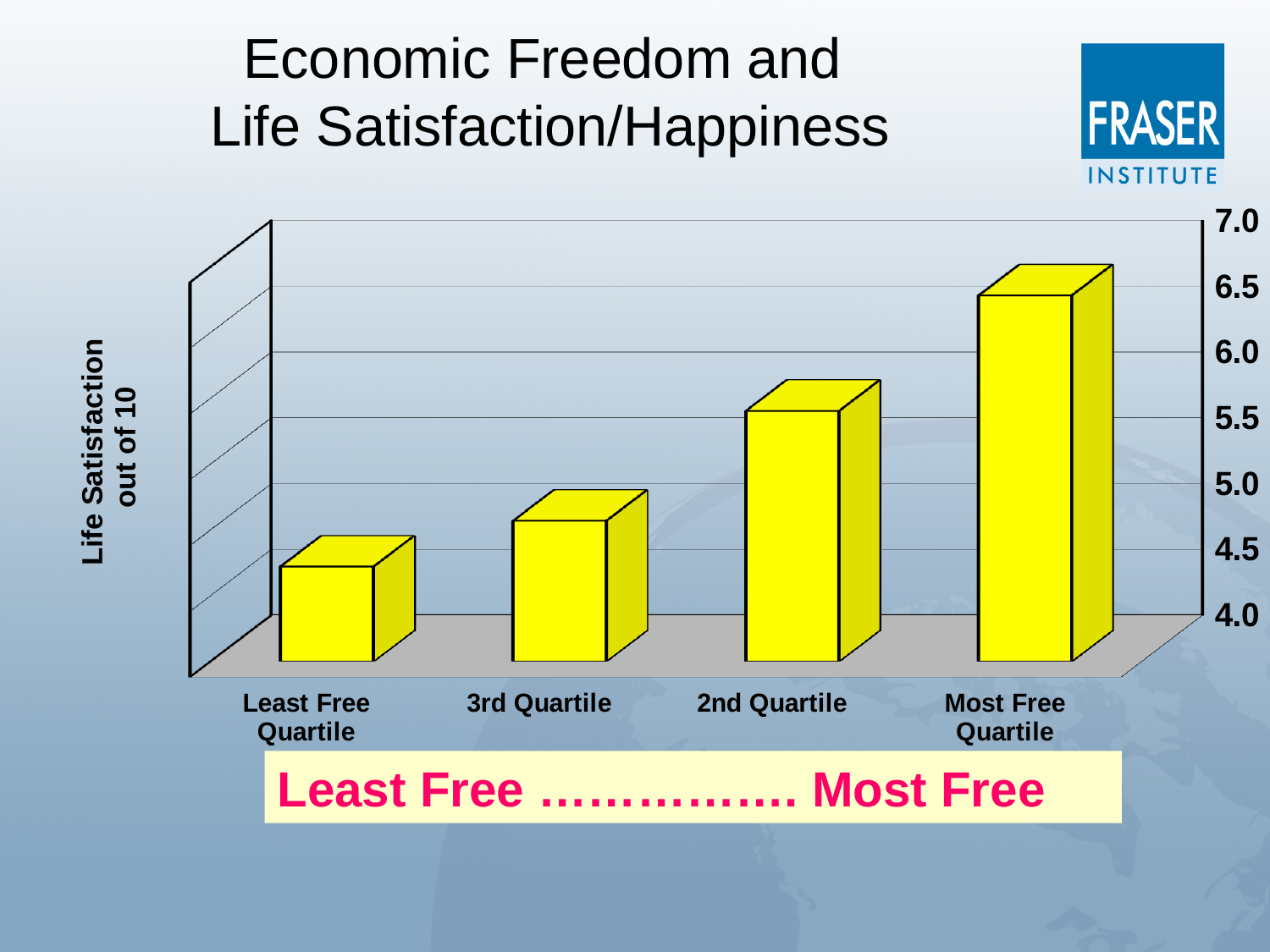
What kind of chart is shown on the slide? bar chart What is the label on the vertical axis of the chart? Life Satisfaction out of 10 Is the value for the Least Free Quartile greater or less than 5.0? less How many quartile categories are plotted on the chart? 4 Which has a higher life satisfaction value, the 2nd Quartile or the 3rd Quartile? 2nd Quartile Do the life satisfaction values rise or fall moving from the Least Free Quartile to the Most Free Quartile? rise Is the value for the 2nd Quartile greater or less than 5.0? greater Is the value for the Most Free Quartile greater or less than 6.0? greater Which quartile has the lowest life satisfaction value? Least Free Quartile Which has a higher life satisfaction value, the Most Free Quartile or the 2nd Quartile? Most Free Quartile Which quartile has the highest life satisfaction value? Most Free Quartile